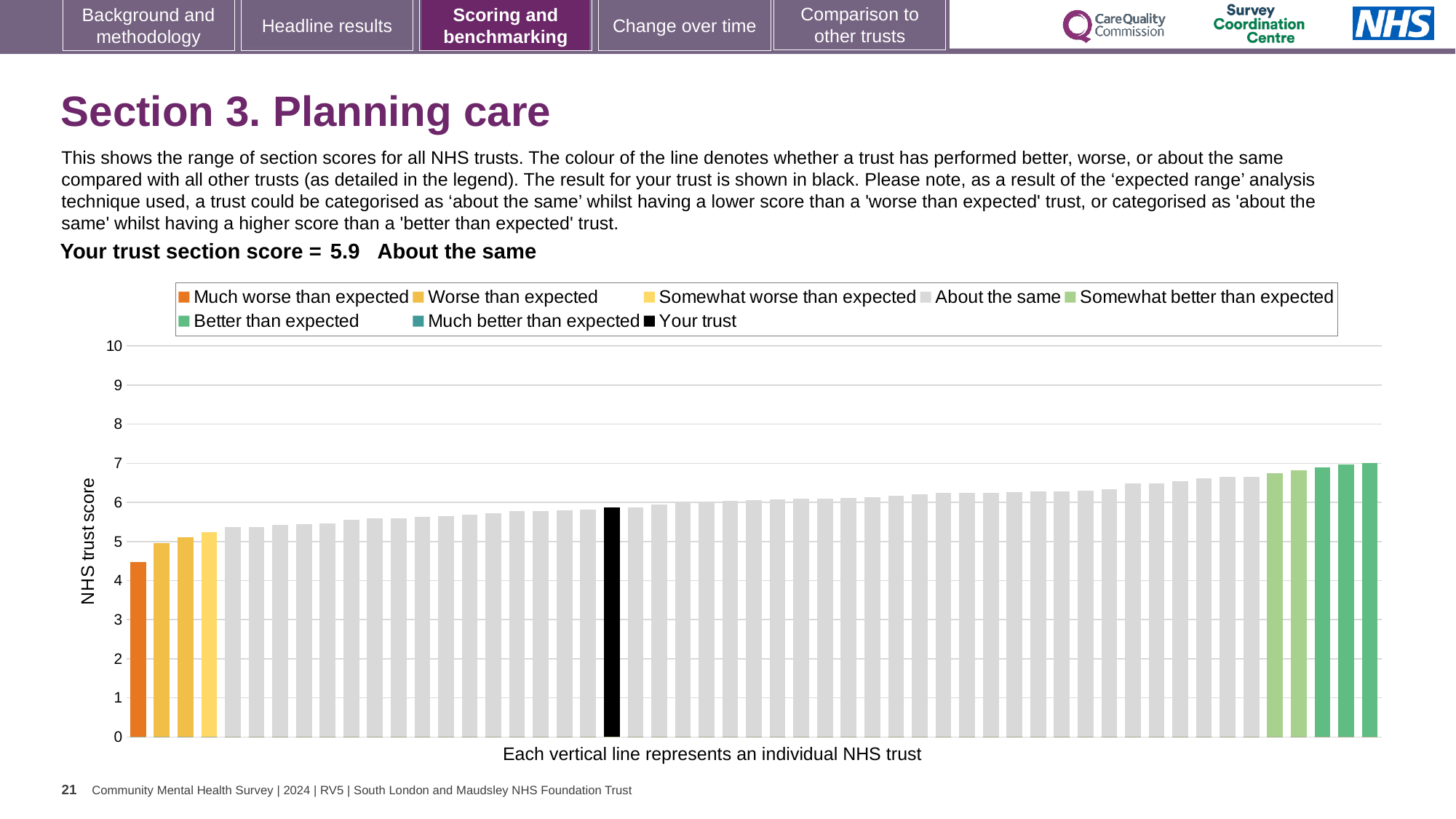
How many entries does the chart legend list? 8 Is the value for the lowest bar (the orange 'Much worse than expected' trust) greater or less than 5? less Which performance category does your trust fall into for this section? About the same What is the section score for your trust shown on the slide? 5.9 Which legend category does the lowest bar on the chart belong to? Much worse than expected How many bars are coloured orange ('Much worse than expected')? 1 Do the bar values rise or fall from left to right along the x axis? rise Is the value for the highest bar on the chart greater or less than 6? greater Is the value for your trust (the black bar) greater or less than 5? greater What colour is the bar representing your trust? black What is the label on the vertical axis of the chart? NHS trust score What kind of chart is shown on the slide? bar chart